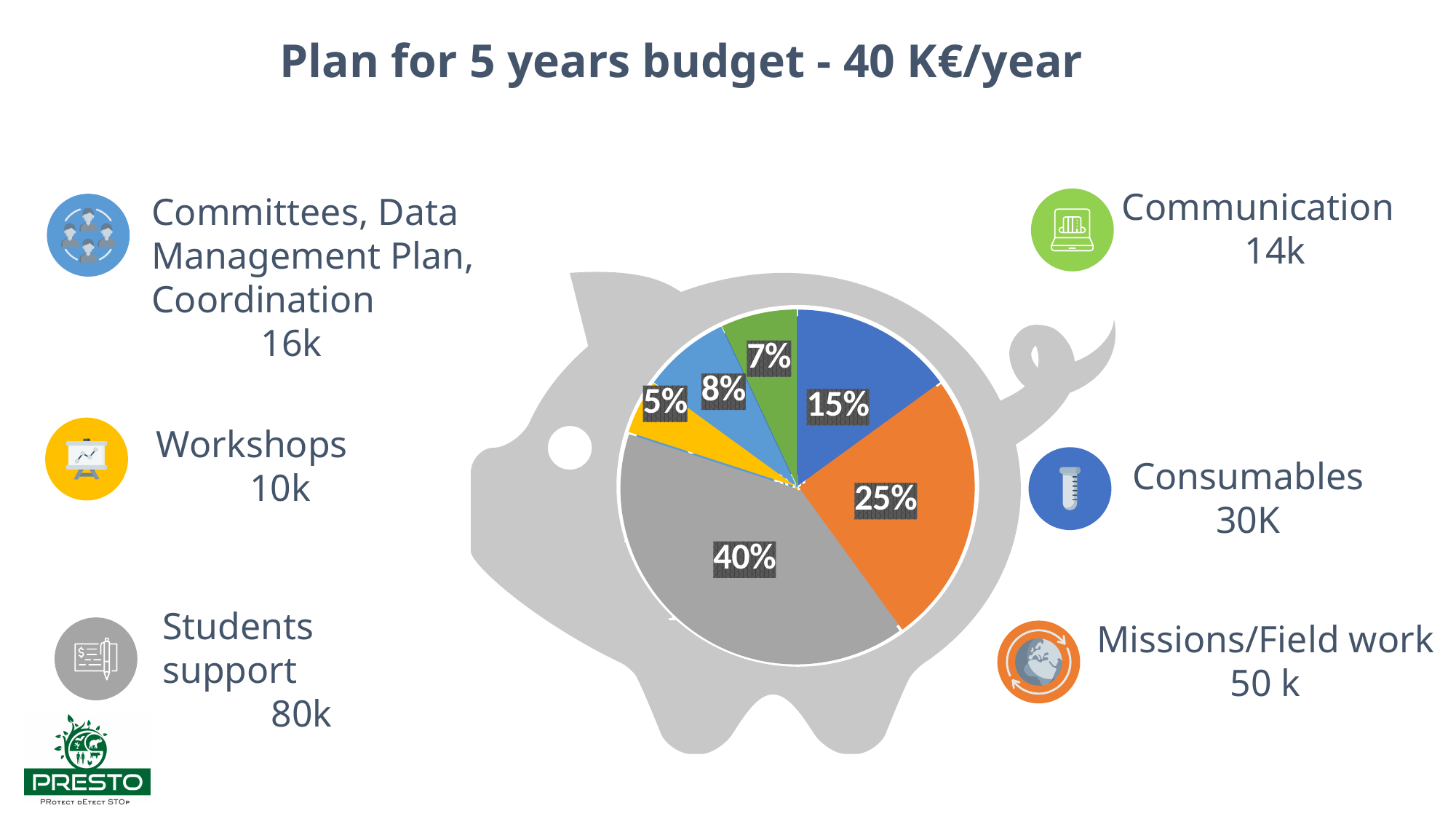
What kind of chart is shown on the slide? pie chart What budget amount is listed for Missions/Field work? 50 k What is the difference between the largest slice (40%) and the orange slice (25%)? 15% What budget amount is listed for Communication? 14k How many slices does the pie chart have? 6 What percentage is shown on the green slice of the pie chart? 7% What is the largest percentage shown on the pie chart? 40% What percentage is shown on the orange slice of the pie chart? 25% Which slice is larger, the dark blue slice or the light blue slice? the dark blue slice (15%) What budget amount is listed for Students support? 80k What is the smallest percentage shown on the pie chart? 5% What is the title of the slide? Plan for 5 years budget - 40 K€/year